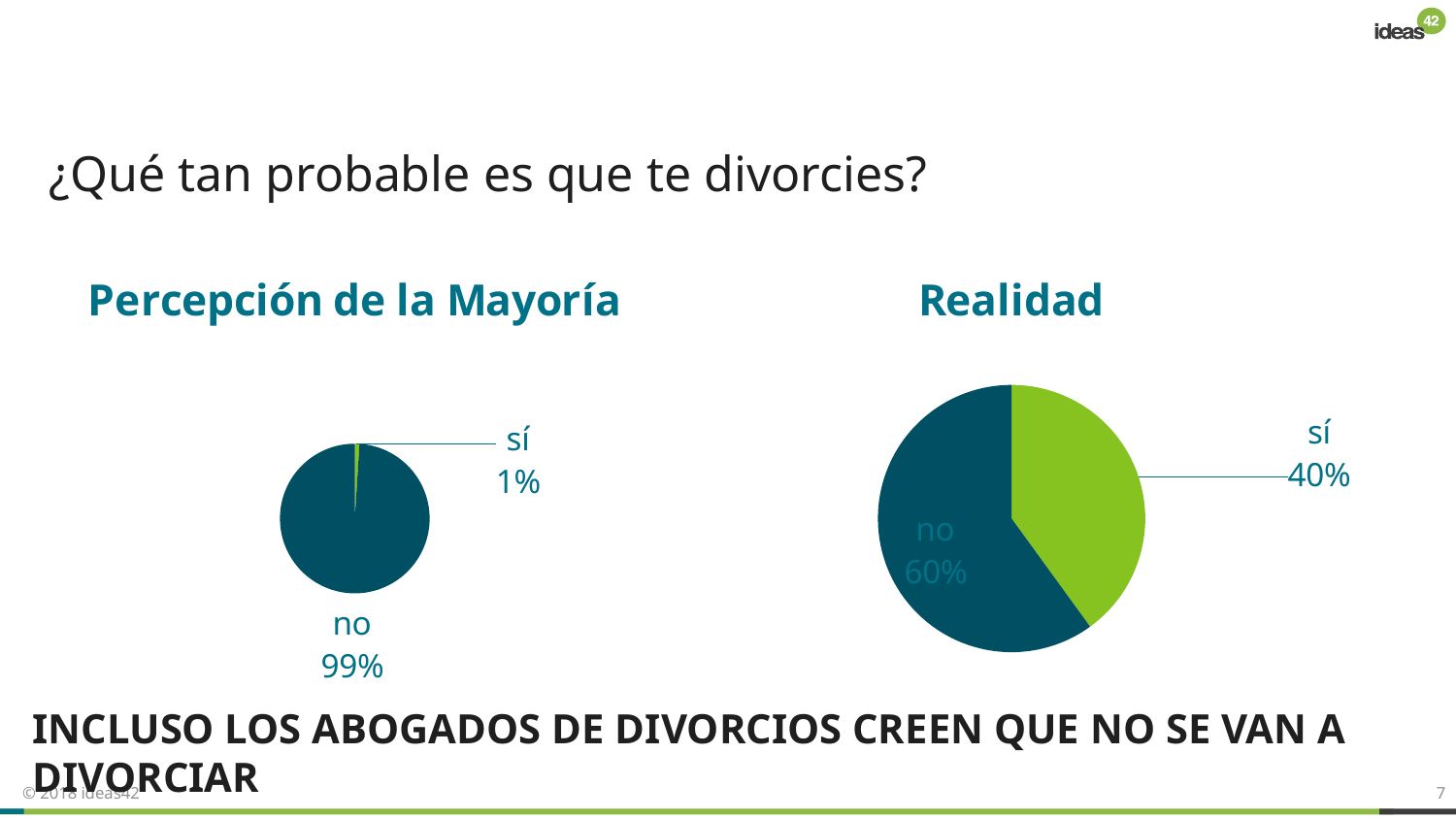
In the 'Realidad' chart, what share is labelled 'no'? 60% In the 'Realidad' chart, what share is labelled 'sí'? 40% How many pie charts are shown on the slide? 2 In the 'Percepción de la Mayoría' chart, which slice is the smallest? sí In the 'Realidad' chart, what is the difference between the 'no' share and the 'sí' share? 20% How many slices does the 'Percepción de la Mayoría' chart have? 2 In the 'Realidad' chart, which slice is larger, 'sí' or 'no'? no What kind of chart is the 'Realidad' chart? Pie chart What is the title of the chart on the right side of the slide? Realidad In the 'Percepción de la Mayoría' chart, what share is labelled 'no'? 99% What is the difference between the 'sí' share in the 'Realidad' chart and the 'sí' share in the 'Percepción de la Mayoría' chart? 39% In the 'Percepción de la Mayoría' chart, what share is labelled 'sí'? 1%